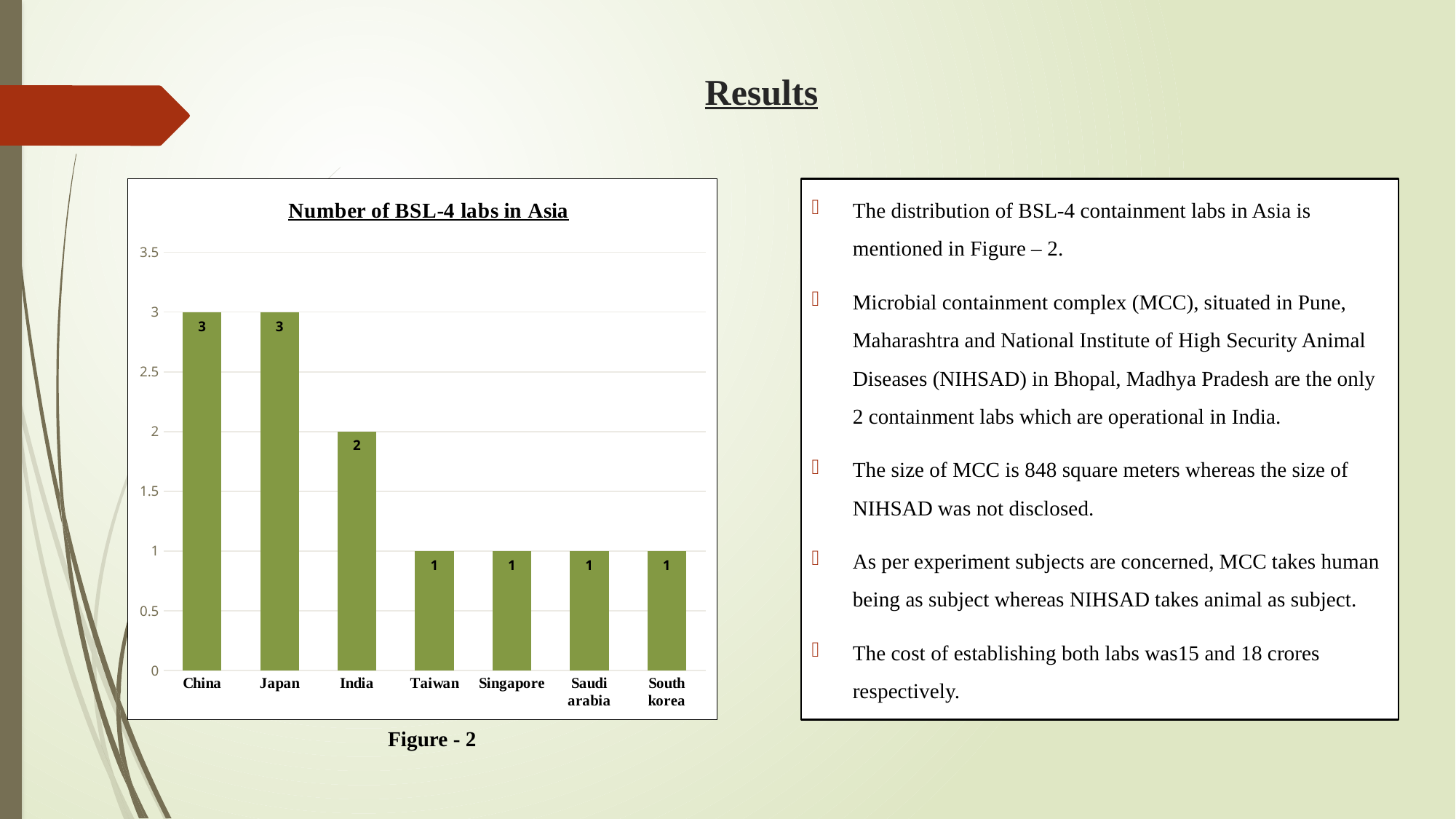
What is the difference between the number of BSL-4 labs in Japan and in India? 1 Which has more BSL-4 labs, India or South korea? India What is the number of BSL-4 labs shown for India? 2 What is the number of BSL-4 labs shown for Singapore? 1 What is the difference between the number of BSL-4 labs in China and in Taiwan? 2 What kind of chart is used to show the number of BSL-4 labs in Asia? Bar chart What is the title of the chart on the slide? Number of BSL-4 labs in Asia What is the number of BSL-4 labs shown for Saudi arabia? 1 How many countries in the chart have exactly 1 BSL-4 lab? 4 Which two countries share the highest number of BSL-4 labs in the chart? China and Japan How many countries are shown on the x axis of the chart? 7 What is the number of BSL-4 labs shown for China? 3